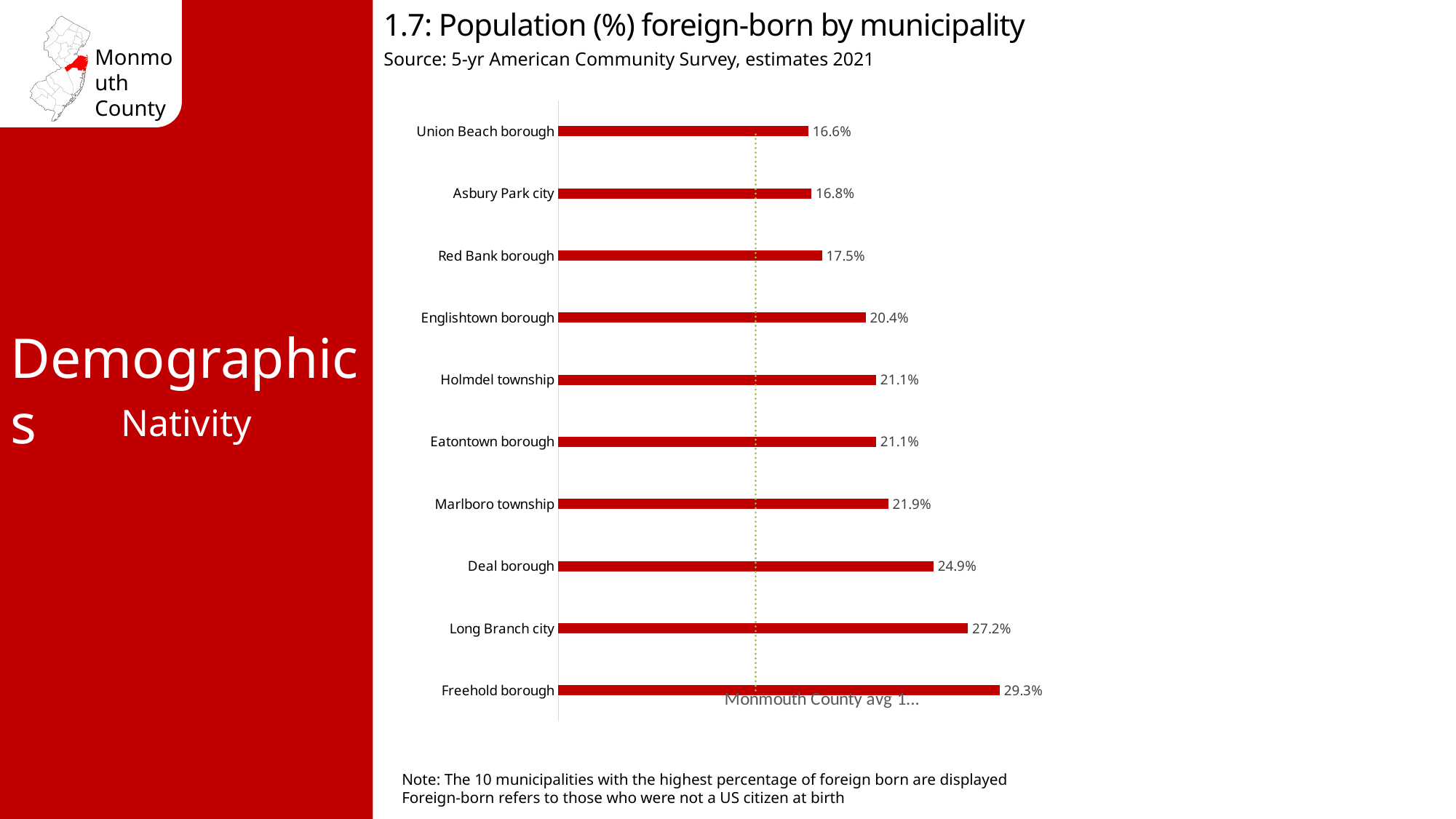
What is the difference in foreign-born percentage between Freehold borough and Long Branch city? 2.1% Which municipality has the highest foreign-born percentage? Freehold borough What is the difference in foreign-born percentage between Marlboro township and Englishtown borough? 1.5% What is the foreign-born population percentage for Deal borough? 24.9% What is the foreign-born population percentage for Red Bank borough? 17.5% What is the foreign-born population percentage for Freehold borough? 29.3% Which municipality has the lowest foreign-born percentage? Union Beach borough What is the title of the chart? 1.7: Population (%) foreign-born by municipality Which has a higher foreign-born percentage, Deal borough or Holmdel township? Deal borough What kind of chart is shown on the slide? Bar chart What is the source of the data shown in the chart? 5-yr American Community Survey, estimates 2021 How many municipalities are shown in the chart? 10